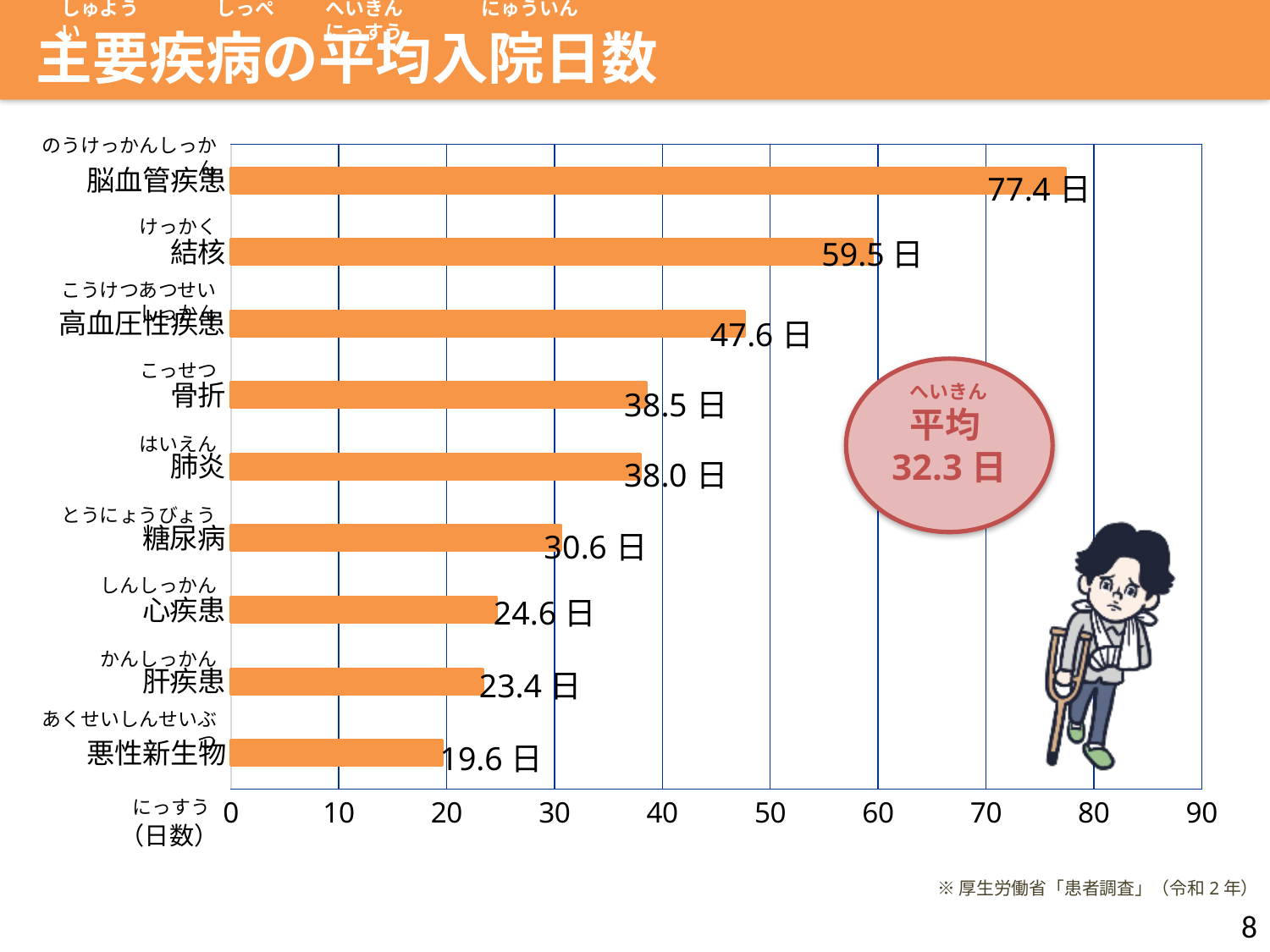
What value is shown for 悪性新生物? 19.6 日 What kind of chart is shown on the slide? bar chart What is the title of the chart? 主要疾病の平均入院日数 What is the difference between the values for 結核 and 高血圧性疾患? 11.9 日 What is the overall average (平均) shown in the circle on the chart? 32.3 日 Which has a larger value, 心疾患 or 肝疾患? 心疾患 Is the value for 骨折 greater or less than 40? less Which disease has the longest average hospitalization? 脳血管疾患 How many diseases are plotted in the chart? 9 Which disease has the shortest average hospitalization? 悪性新生物 What is the average hospitalization length shown for 脳血管疾患? 77.4 日 What value is shown for 糖尿病? 30.6 日